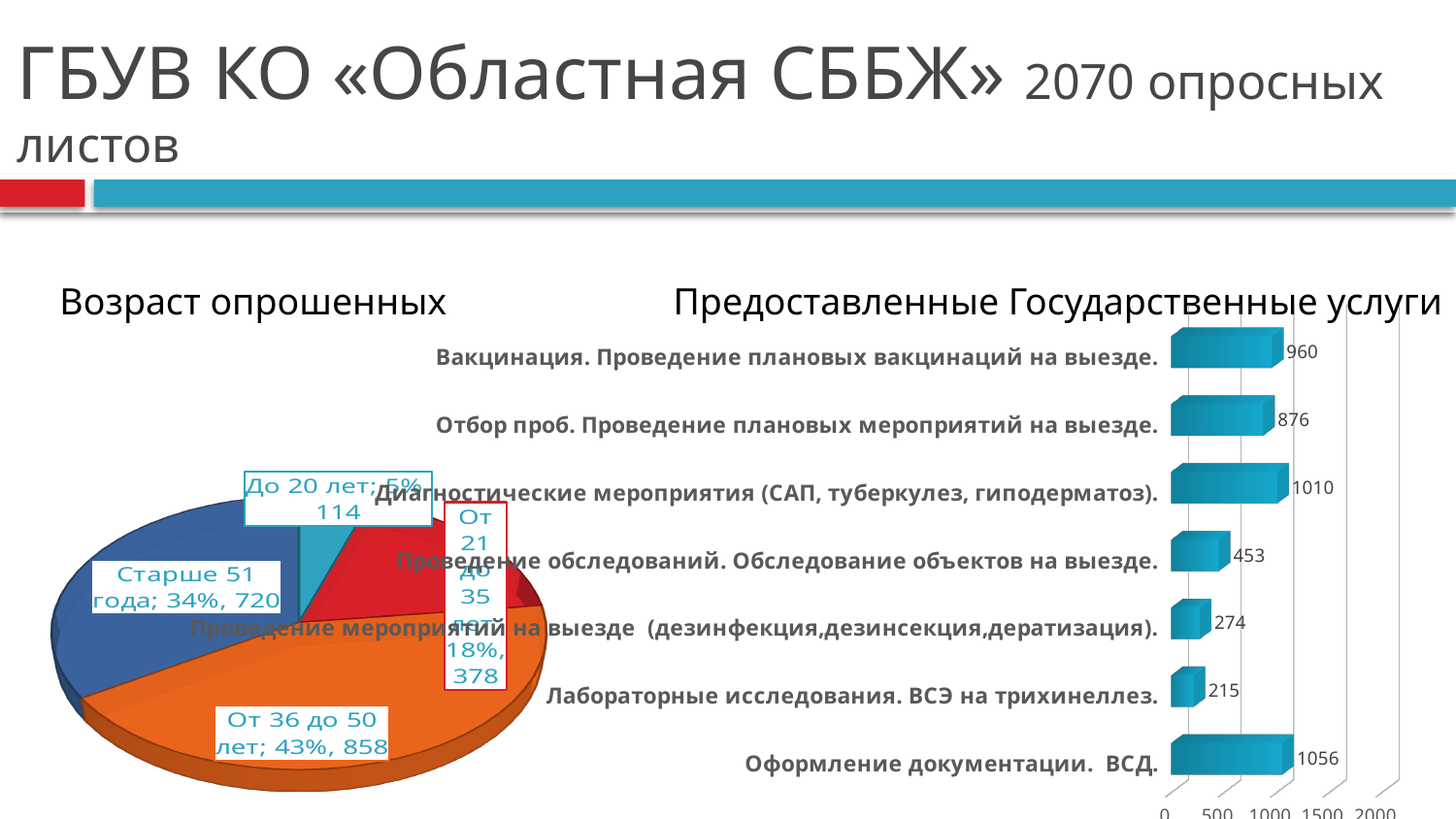
In the chart 'Предоставленные Государственные услуги', which category has the highest value? Оформление документации. ВСД. In the chart 'Предоставленные Государственные услуги', which category has the lowest value? Лабораторные исследования. ВСЭ на трихинеллез. What type of chart is 'Возраст опрошенных'? pie chart In the chart 'Предоставленные Государственные услуги', what is the difference between the values for 'Вакцинация. Проведение плановых вакцинаций на выезде.' and 'Отбор проб. Проведение плановых мероприятий на выезде.'? 84 In the chart 'Предоставленные Государственные услуги', what is the value for 'Лабораторные исследования. ВСЭ на трихинеллез.'? 215 What type of chart is 'Предоставленные Государственные услуги'? bar chart In the chart 'Предоставленные Государственные услуги', which is larger: 'Проведение обследований. Обследование объектов на выезде.' or 'Проведение мероприятий на выезде (дезинфекция,дезинсекция,дератизация).'? Проведение обследований. Обследование объектов на выезде. In the chart 'Возраст опрошенных', how many respondents are 'Старше 51 года'? 720 In the chart 'Возраст опрошенных', what share of respondents are 'От 36 до 50 лет'? 43% In the chart 'Предоставленные Государственные услуги', is the value for 'Диагностические мероприятия (САП, туберкулез, гиподерматоз).' greater or less than 1000? greater In the chart 'Предоставленные Государственные услуги', what is the value for 'Оформление документации. ВСД.'? 1056 How many categories are shown in the chart 'Предоставленные Государственные услуги'? 7